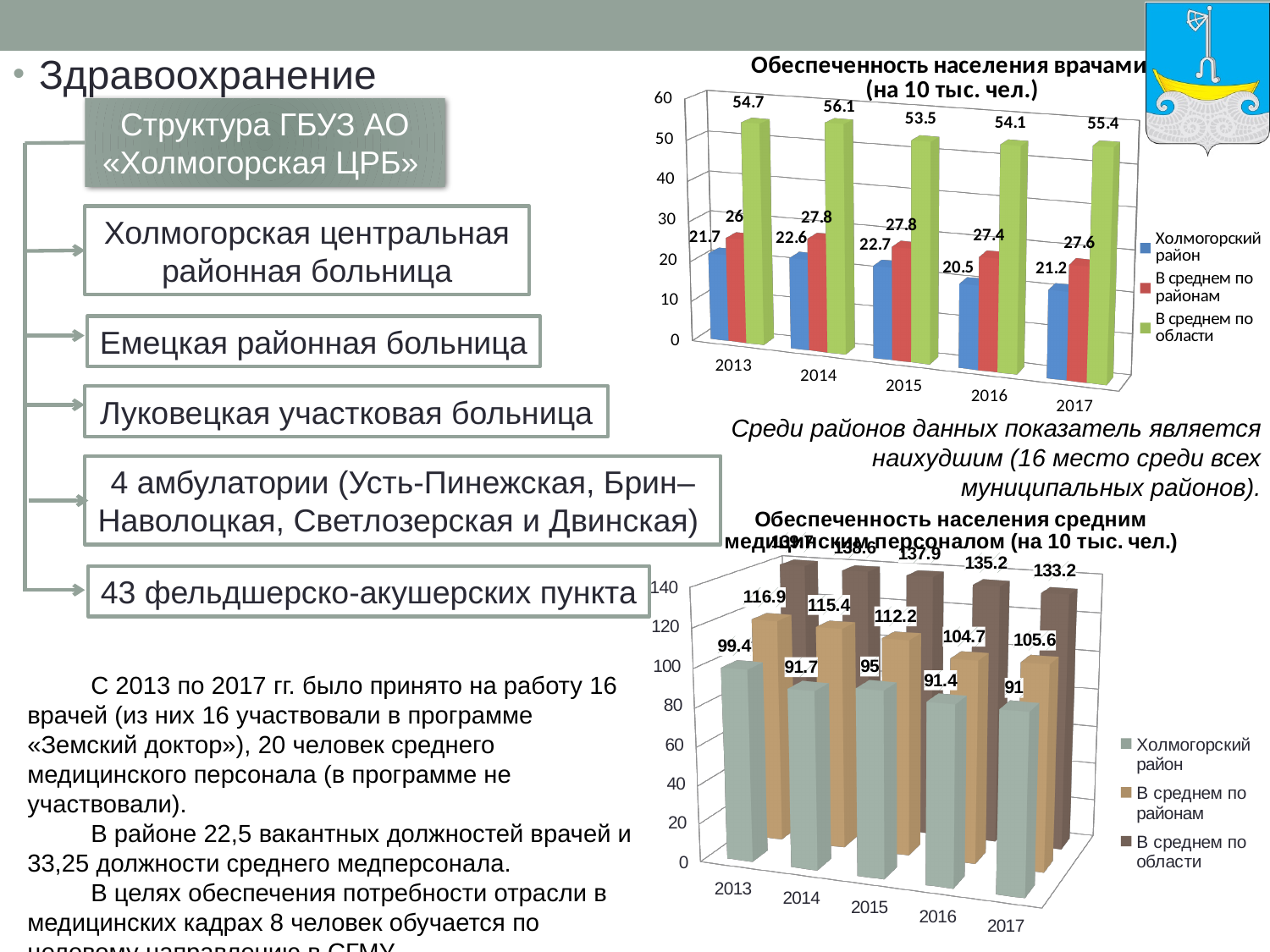
What type of chart is 'Обеспеченность населения врачами (на 10 тыс. чел.)'? Bar chart In the chart 'Обеспеченность населения средним медицинским персоналом (на 10 тыс. чел.)', which year has the highest value for Холмогорский район? 2013 In the chart 'Обеспеченность населения врачами (на 10 тыс. чел.)', what is the value for Холмогорский район in 2013? 21.7 In the chart 'Обеспеченность населения врачами (на 10 тыс. чел.)', what is the value for 'В среднем по области' in 2014? 56.1 In the chart 'Обеспеченность населения средним медицинским персоналом (на 10 тыс. чел.)', what is the value for 'В среднем по районам' in 2016? 104.7 In the chart 'Обеспеченность населения врачами (на 10 тыс. чел.)', what is the difference between 'В среднем по области' and Холмогорский район in 2017? 34.2 In the chart 'Обеспеченность населения врачами (на 10 тыс. чел.)', which year has the lowest value for Холмогорский район? 2016 In the chart 'Обеспеченность населения средним медицинским персоналом (на 10 тыс. чел.)', is the value for 'В среднем по области' in 2017 greater or less than 120? greater In the chart 'Обеспеченность населения средним медицинским персоналом (на 10 тыс. чел.)', which is larger in 2015: Холмогорский район or 'В среднем по районам'? В среднем по районам In the chart 'Обеспеченность населения врачами (на 10 тыс. чел.)', how many series does the legend list? 3 In the chart 'Обеспеченность населения врачами (на 10 тыс. чел.)', how many years are shown on the x axis? 5 In the chart 'Обеспеченность населения средним медицинским персоналом (на 10 тыс. чел.)', what is the value for Холмогорский район in 2013? 99.4